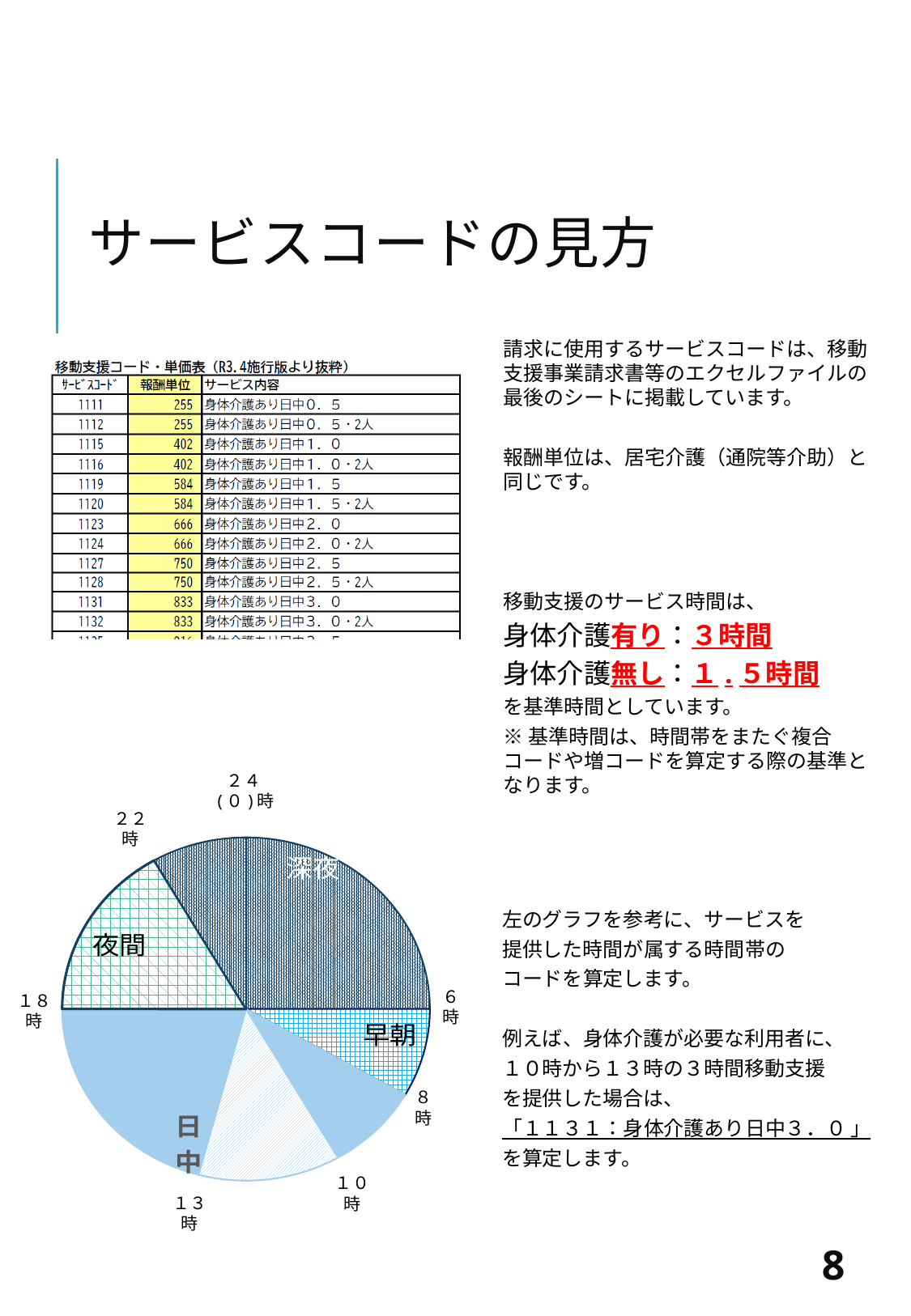
Which time band on the pie chart is the smallest slice? 早朝 What clock-time label appears at the top of the pie chart? 24(0)時 Which time band on the pie chart lies between the 18時 and 22時 marks? 夜間 On the pie chart, which slice is larger, 深夜 or 早朝? 深夜 On the pie chart, which slice is larger, 深夜 or 夜間? 深夜 What kind of chart is shown at the bottom left of the slide? pie chart On the pie chart, which slice is larger, 夜間 or 早朝? 夜間 How many clock-time labels are placed around the outside of the pie chart? 7 How many named time bands (深夜, 早朝, 日中, 夜間) are labelled on the pie chart? 4 Which time band on the pie chart lies between the 6時 and 8時 marks? 早朝